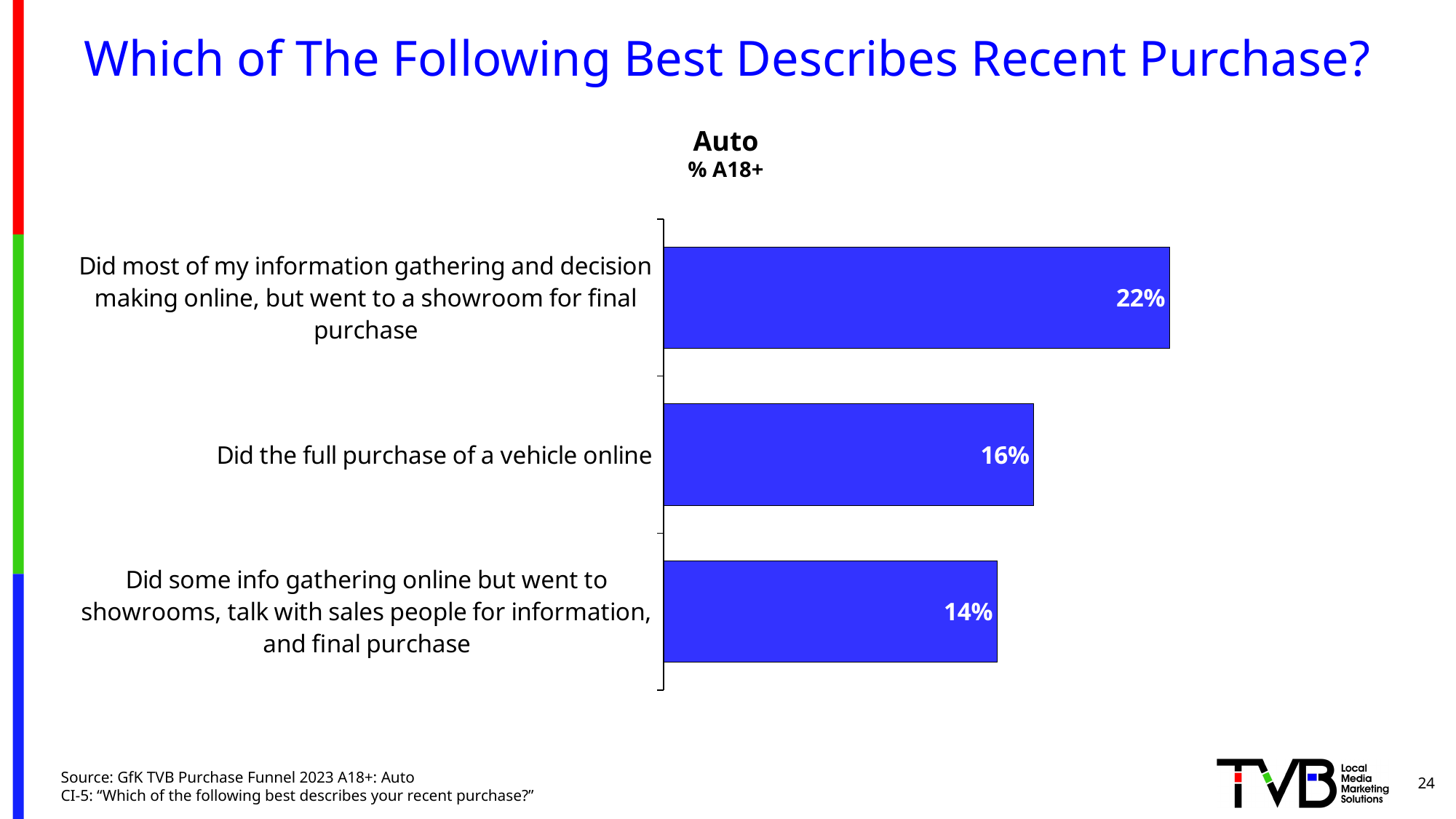
Which purchase description has the highest percentage? Did most of my information gathering and decision making online, but went to a showroom for final purchase What is the difference in percentage points between those who did most information gathering online but went to a showroom for final purchase and those who did the full purchase online? 6 What percentage of A18+ did some info gathering online but went to showrooms, talked with sales people for information, and made the final purchase there? 14% What is the difference in percentage points between those who did the full purchase online and those who did some info gathering online but went to showrooms? 2 Which purchase description has the lowest percentage? Did some info gathering online but went to showrooms, talk with sales people for information, and final purchase What is the source cited for the chart data? GfK TVB Purchase Funnel 2023 A18+: Auto Which is larger: the percentage who did the full purchase of a vehicle online, or the percentage who did some info gathering online but went to showrooms for information and final purchase? Did the full purchase of a vehicle online What percentage of A18+ did most of their information gathering and decision making online, but went to a showroom for final purchase? 22% What is the title of the chart? Auto How many purchase descriptions are shown in the chart? 3 What type of chart is shown on the slide? Bar chart What percentage of A18+ did the full purchase of a vehicle online? 16%